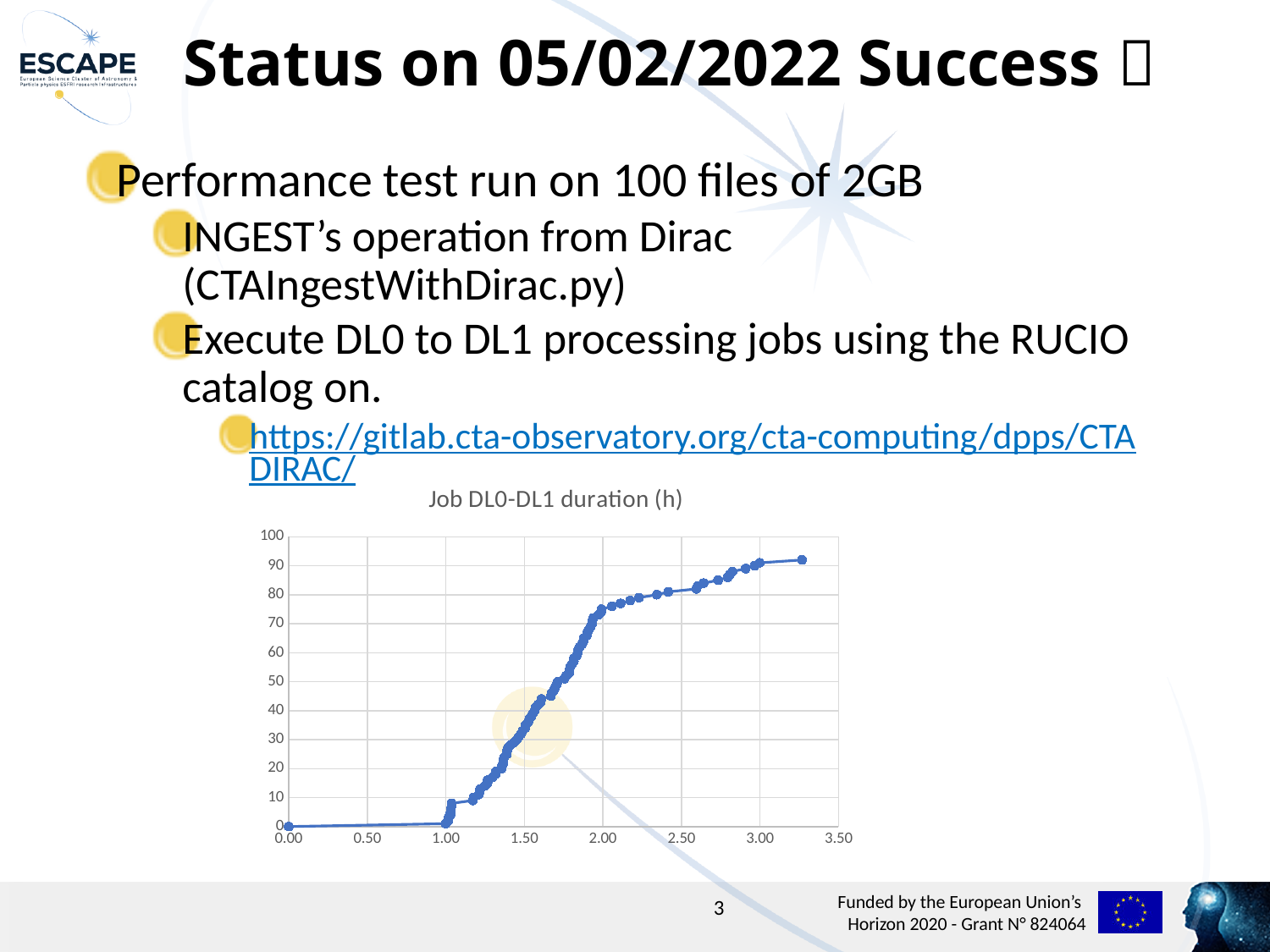
Is the plotted value at x = 1.50 greater or less than 60? less What is the maximum value shown on the y axis of the chart? 100 Is the highest plotted value on the chart greater or less than 100? less What kind of chart is shown on the slide? scatter chart Is the plotted value at x = 1.00 greater or less than 20? less What is the title of the chart on the slide? Job DL0-DL1 duration (h) Do the plotted values rise or fall as the x-axis value increases? rise